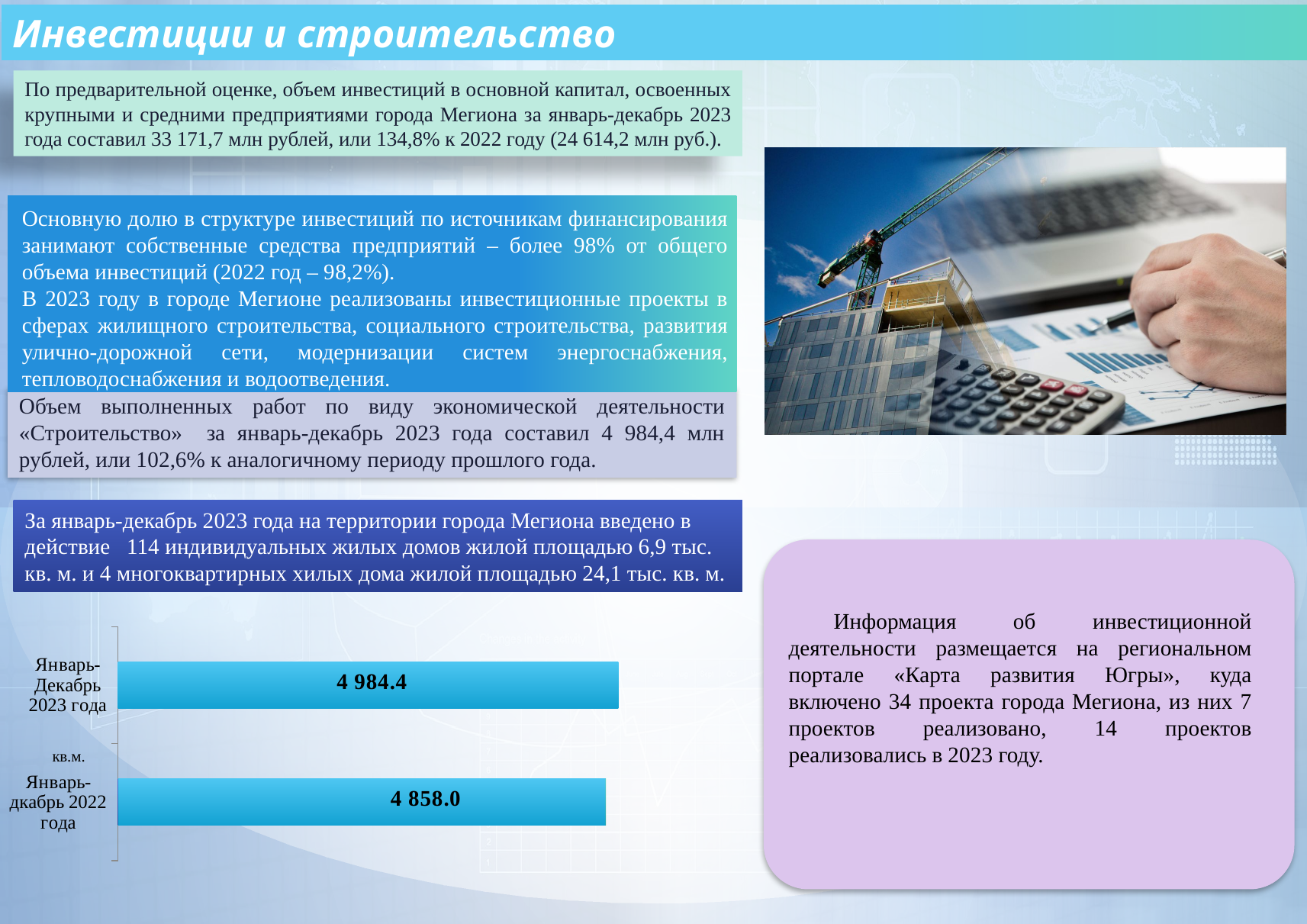
What is the value for Январь-дкабрь 2022 года in the bar chart? 4 858.0 What is the value for Январь-Декабрь 2023 года in the bar chart? 4 984.4 How many categories are shown in the bar chart? 2 Which category has the highest value in the bar chart? Январь-Декабрь 2023 года Which category has the lowest value in the bar chart? Январь-дкабрь 2022 года What kind of chart is shown at the bottom left of the slide? Bar chart Are the bars in the chart oriented horizontally or vertically? Horizontally Which is larger in the bar chart: the value for Январь-Декабрь 2023 года or for Январь-дкабрь 2022 года? Январь-Декабрь 2023 года What colour are the bars in the chart? Blue What is the difference between the values for Январь-Декабрь 2023 года and Январь-дкабрь 2022 года in the bar chart? 126.4